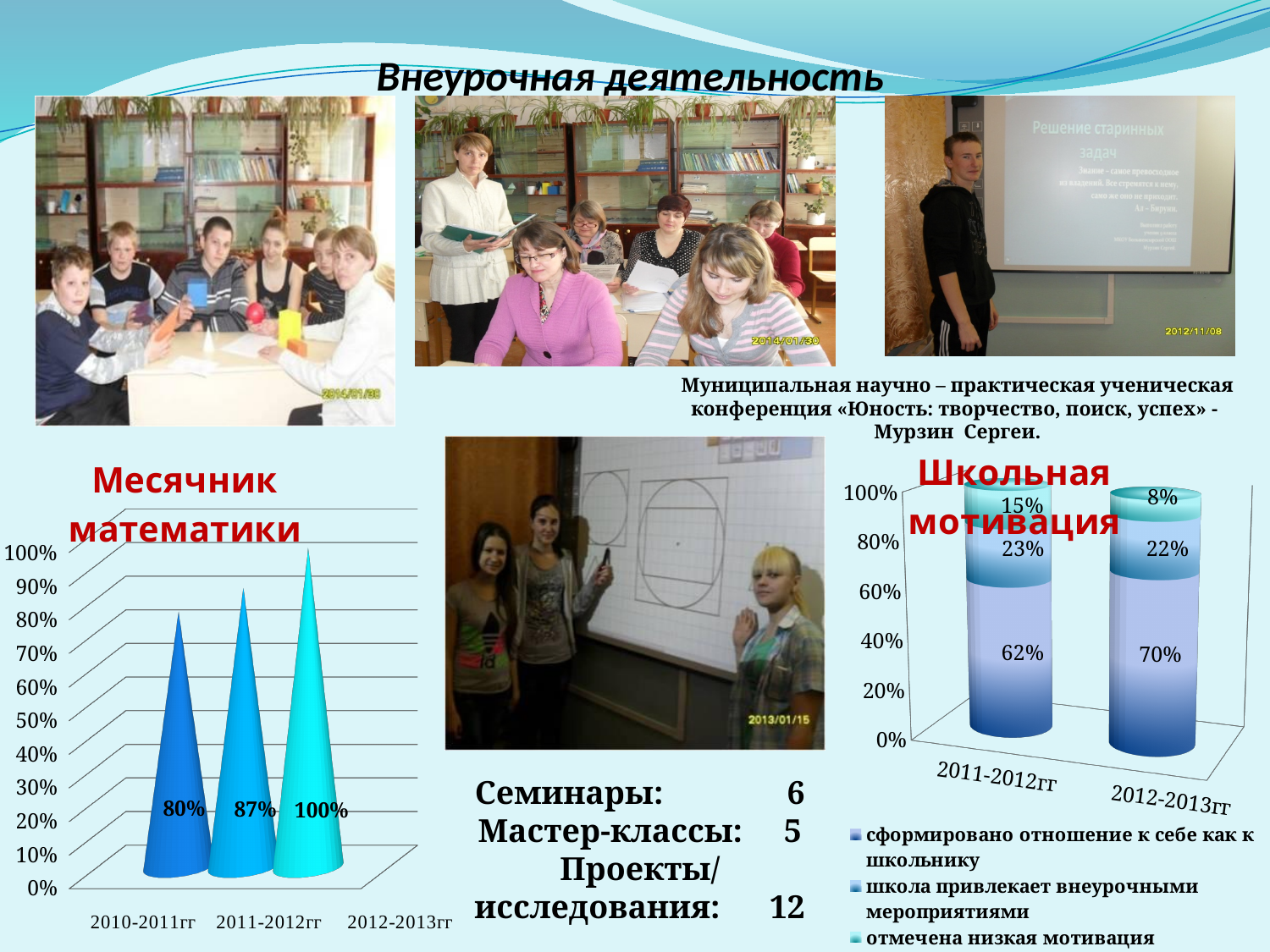
In the 'Школьная мотивация' chart, what is the value of the top segment ('отмечена низкая мотивация') for 2011-2012гг? 15% How many categories are shown in the 'Месячник математики' chart? 3 In the 'Месячник математики' chart, what is the value for 2010-2011гг? 80% In the 'Месячник математики' chart, what is the value for 2011-2012гг? 87% In the 'Месячник математики' chart, which year has the lowest value? 2010-2011гг In the 'Школьная мотивация' chart, what is the value of the bottom segment for 2012-2013гг? 70% In the 'Школьная мотивация' chart, which year has the larger bottom segment, 2011-2012гг or 2012-2013гг? 2012-2013гг How many series does the legend of the 'Школьная мотивация' chart list? 3 What is the total of the stacked bar for 2011-2012гг in the 'Школьная мотивация' chart? 100% In the 'Месячник математики' chart, what is the difference between the values for 2012-2013гг and 2010-2011гг? 20% In the 'Месячник математики' chart, which year has the highest value? 2012-2013гг In the 'Месячник математики' chart, do the values rise or fall from 2010-2011гг to 2012-2013гг? rise